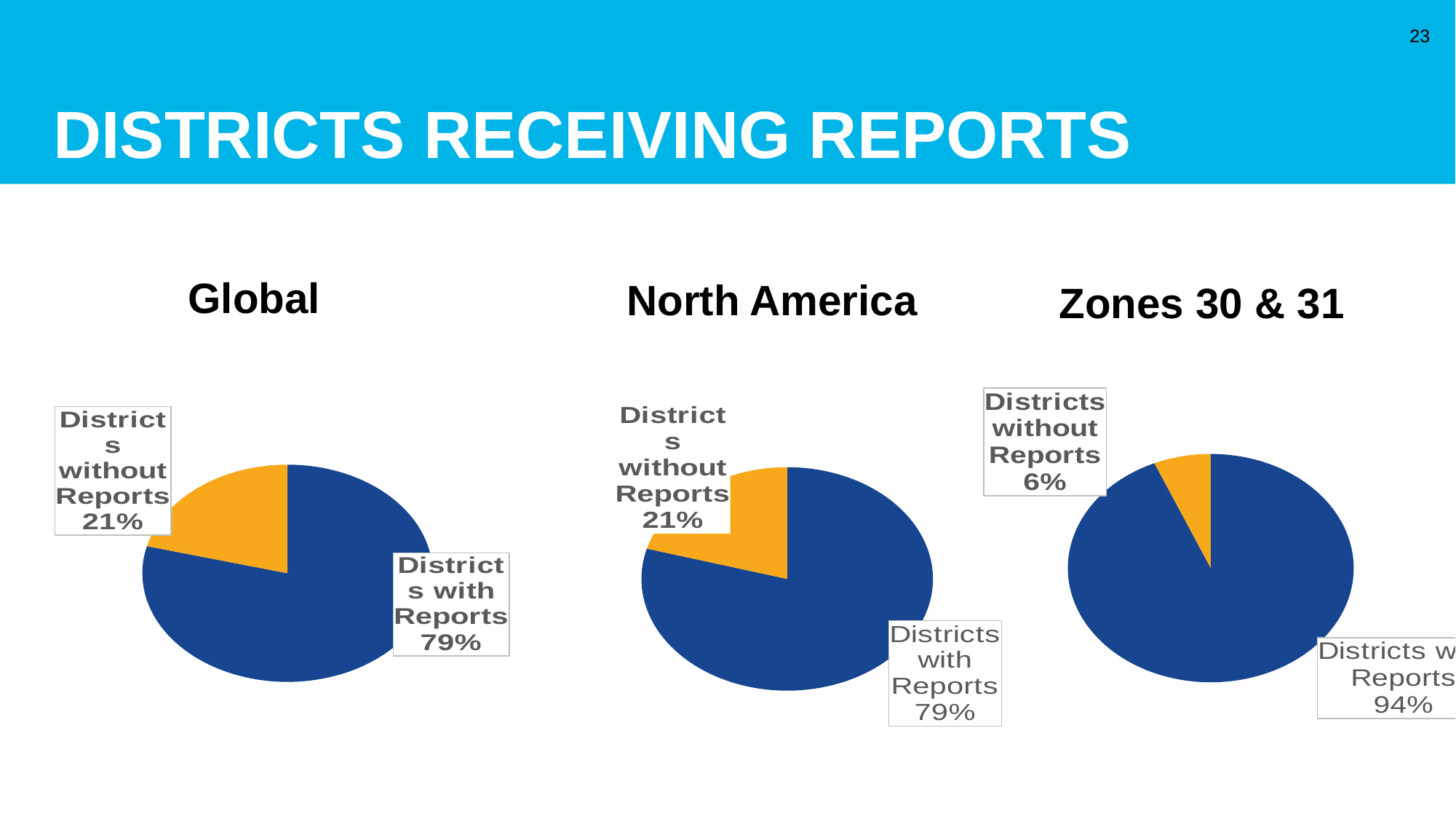
In the Global chart, what percentage of districts are with reports? 79% In the North America chart, what share of districts are with reports? 79% How many pie charts are shown on the slide? 3 In the Zones 30 & 31 chart, what percentage of districts are without reports? 6% What kind of chart is the Global chart? Pie chart In the Global chart, which slice is larger: Districts with Reports or Districts without Reports? Districts with Reports In the Zones 30 & 31 chart, what is the difference between the share of districts with reports and the share without reports? 88% In the North America chart, what percentage of districts are without reports? 21% How many slices does the North America pie chart have? 2 In the Global chart, what percentage of districts are without reports? 21% In the Zones 30 & 31 chart, what share of districts are with reports? 94% In the Zones 30 & 31 chart, which category has the smallest slice? Districts without Reports